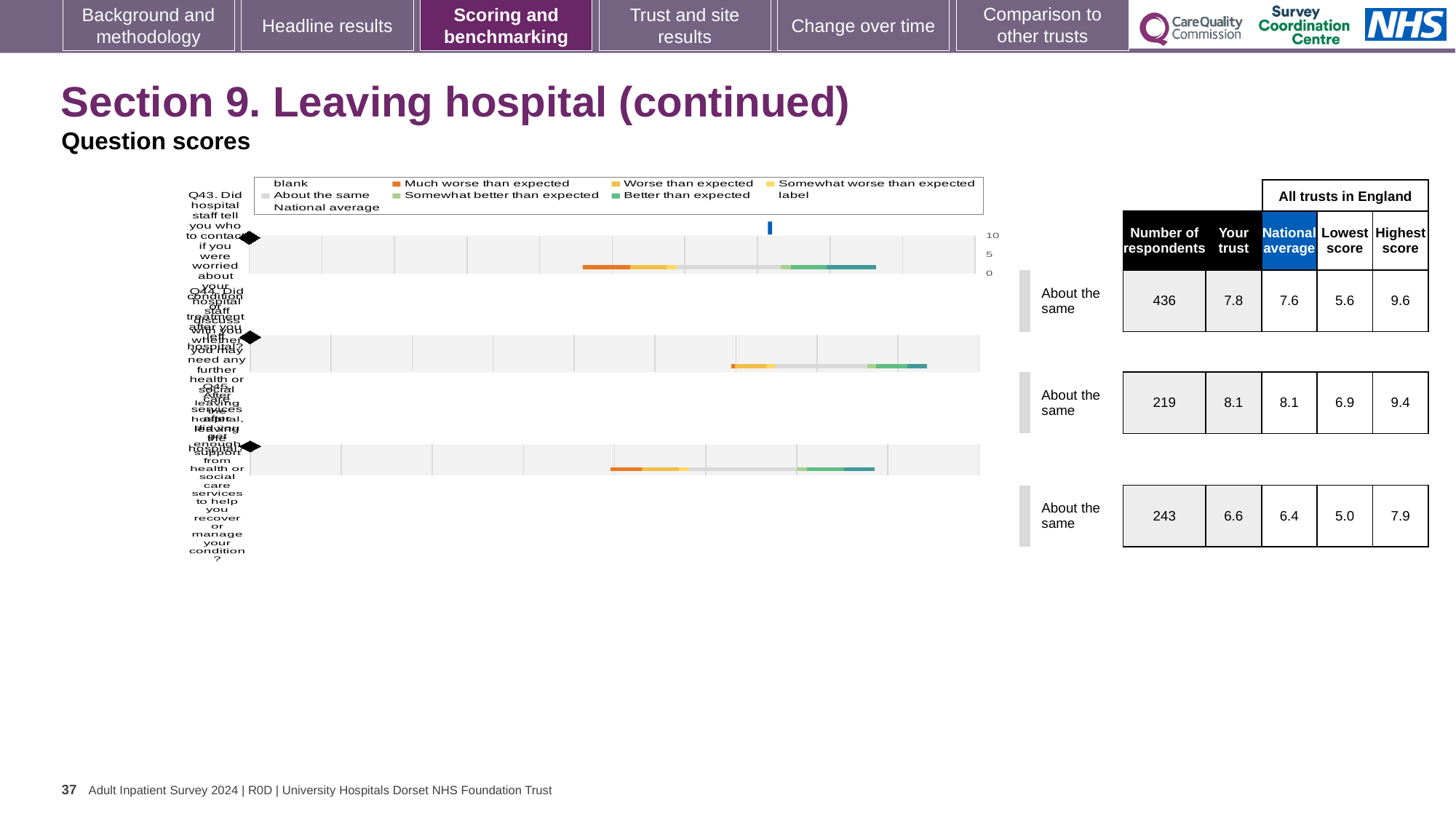
For the first (top) chart, Q43, is the 'Your trust' score larger or smaller than the national average? larger For the first (top) chart, Q43, what is the 'Your trust' score shown in the table? 7.8 In the chart legend, what colour represents 'Much worse than expected'? Orange For the third (bottom) chart, what is the difference between the 'Your trust' score and the national average? 0.2 How many benchmark charts are shown on the slide? 3 Which of the three charts has the highest 'Your trust' score? The second (middle) chart For the first (top) chart, Q43, what is the national average score shown in the table? 7.6 For the first (top) chart, Q43, what is the number of respondents shown in the table? 436 What benchmark category label is shown next to each of the three charts? About the same For the third (bottom) chart, what is the lowest score among all trusts in England? 5.0 For the second (middle) chart, what is the 'Your trust' score shown in the table? 8.1 For the second (middle) chart, what is the highest score among all trusts in England? 9.4